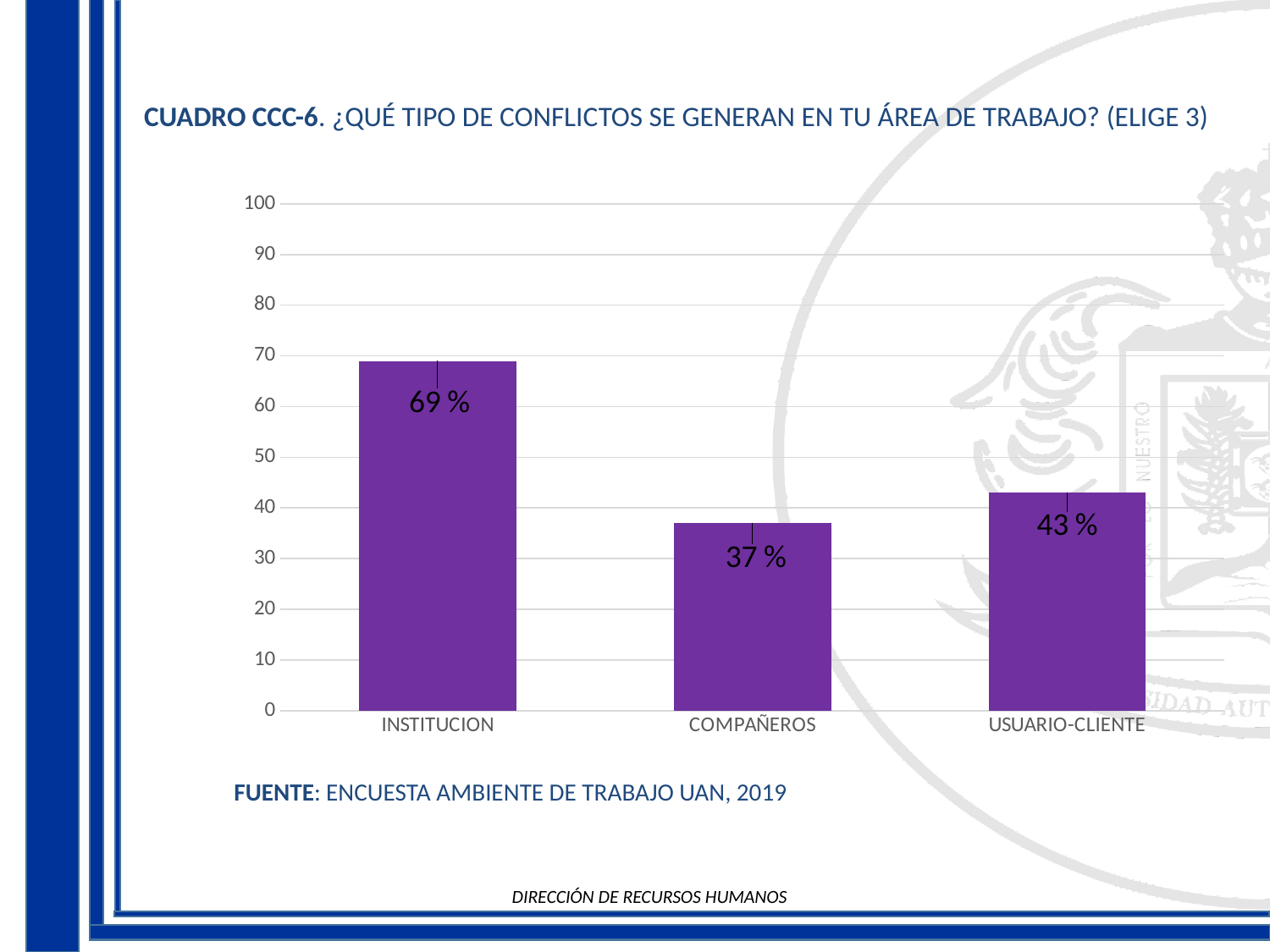
What is the difference between the values for USUARIO-CLIENTE and COMPAÑEROS? 6 % What kind of chart is shown on the slide? bar chart Is the value for INSTITUCION greater or less than 60? greater How many categories are shown on the chart? 3 What is the difference between the values for INSTITUCION and COMPAÑEROS? 32 % What is the value for INSTITUCION? 69 % Which is larger, the value for USUARIO-CLIENTE or the value for COMPAÑEROS? USUARIO-CLIENTE What is the value for USUARIO-CLIENTE? 43 % What is the source cited below the chart? ENCUESTA AMBIENTE DE TRABAJO UAN, 2019 Which category has the lowest value? COMPAÑEROS What is the value for COMPAÑEROS? 37 % Which category has the highest value? INSTITUCION